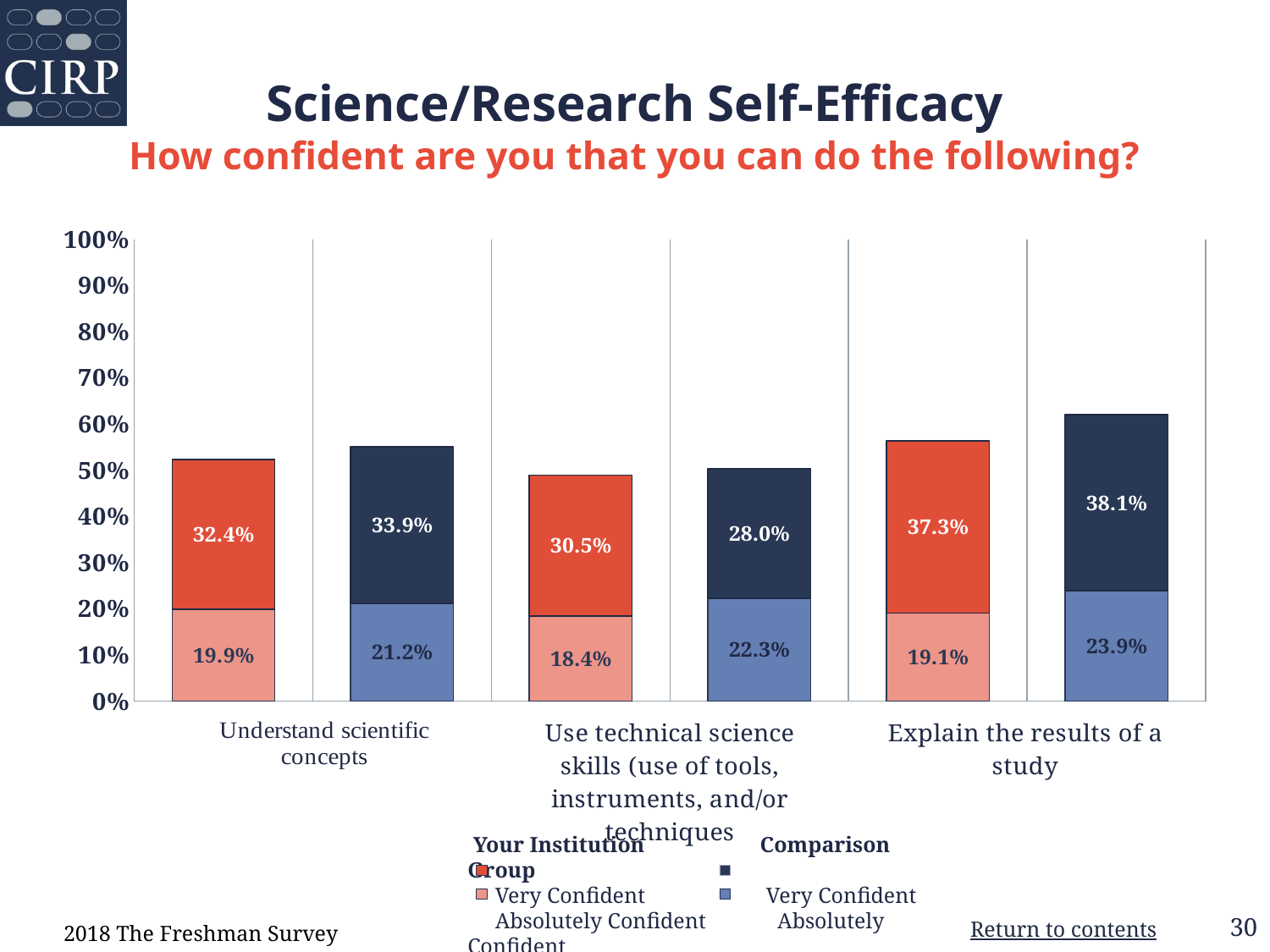
Which item has the highest Absolutely Confident value for Your Institution? Understand scientific concepts What is the difference between the Comparison Group's and Your Institution's Absolutely Confident values for "Explain the results of a study"? 4.8% What is the Very Confident value for the Comparison Group for "Use technical science skills"? 28.0% What is the Absolutely Confident value for the Comparison Group for "Explain the results of a study"? 23.9% Which item has the lowest Very Confident value for Your Institution? Use technical science skills How many items (categories) are shown on the x axis? 3 What is the total of the stacked bar for the Comparison Group for "Explain the results of a study"? 62.0% For "Use technical science skills", which is larger: Your Institution's Absolutely Confident value or the Comparison Group's Absolutely Confident value? Comparison Group (22.3%) What is the Absolutely Confident value for Your Institution for "Understand scientific concepts"? 19.9% What kind of chart is shown on the slide? stacked bar chart How many series does the legend list? 4 What is the total of the stacked bar for Your Institution for "Understand scientific concepts"? 52.3%